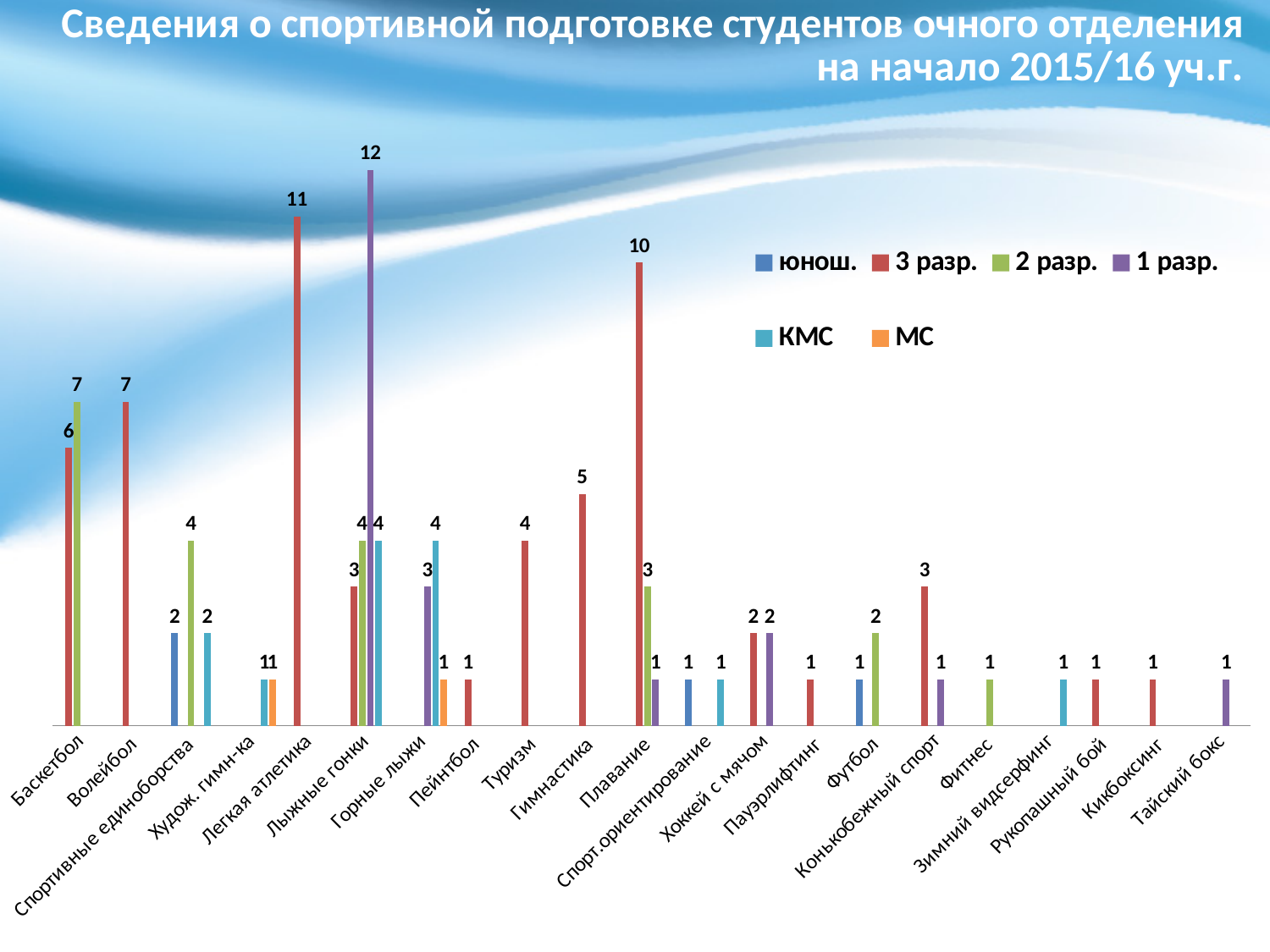
What kind of chart is shown on the slide? bar chart What is the difference between the 3 разр. value for Легкая атлетика and the 3 разр. value for Плавание? 1 What is the value of the 3 разр. series for Плавание? 10 What is the value of the 3 разр. series for Легкая атлетика? 11 What is the value of the 1 разр. series for Лыжные гонки? 12 Which is larger: the 3 разр. value for Волейбол or the 3 разр. value for Гимнастика? Волейбол How many series does the legend list? 6 Which series is shown in orange in the legend? МС Which category has the tallest bar in the chart? Лыжные гонки What is the value of the 2 разр. series for Баскетбол? 7 What is the value of the 3 разр. series for Гимнастика? 5 How many sport categories are shown along the x axis? 21